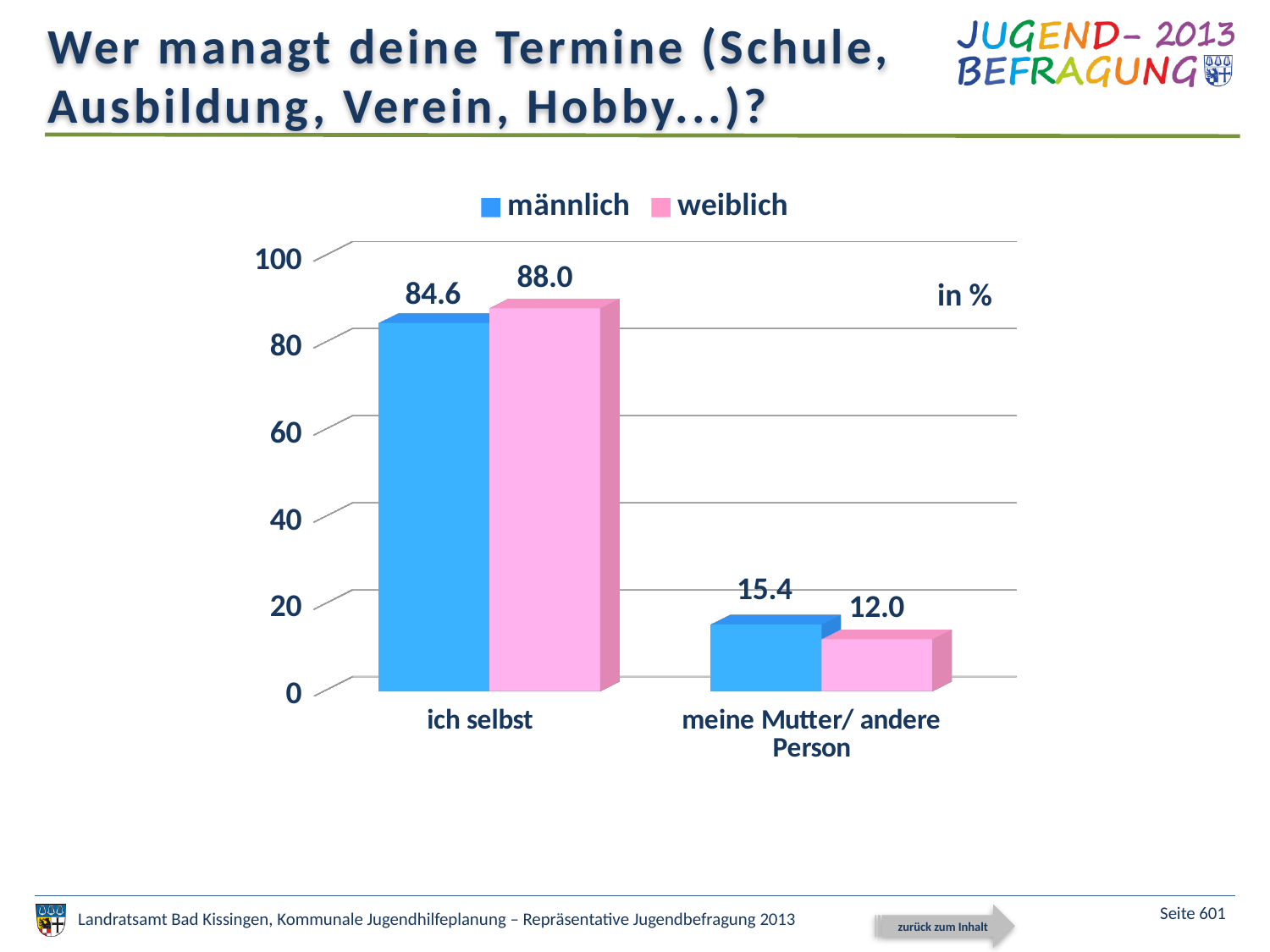
What is the value for weiblich in the category 'ich selbst'? 88.0 What is the value for männlich in the category 'ich selbst'? 84.6 Which category has the highest value for männlich? ich selbst What kind of chart is shown on the slide? bar chart Which series has the higher value in the category 'meine Mutter/ andere Person'? männlich Which series has the higher value in the category 'ich selbst'? weiblich What is the difference between the weiblich and männlich values for 'ich selbst'? 3.4 What is the value for männlich in the category 'meine Mutter/ andere Person'? 15.4 How many categories are shown on the x axis? 2 What is the value for weiblich in the category 'meine Mutter/ andere Person'? 12.0 How many series does the legend list? 2 What is the difference between the männlich and weiblich values for 'meine Mutter/ andere Person'? 3.4